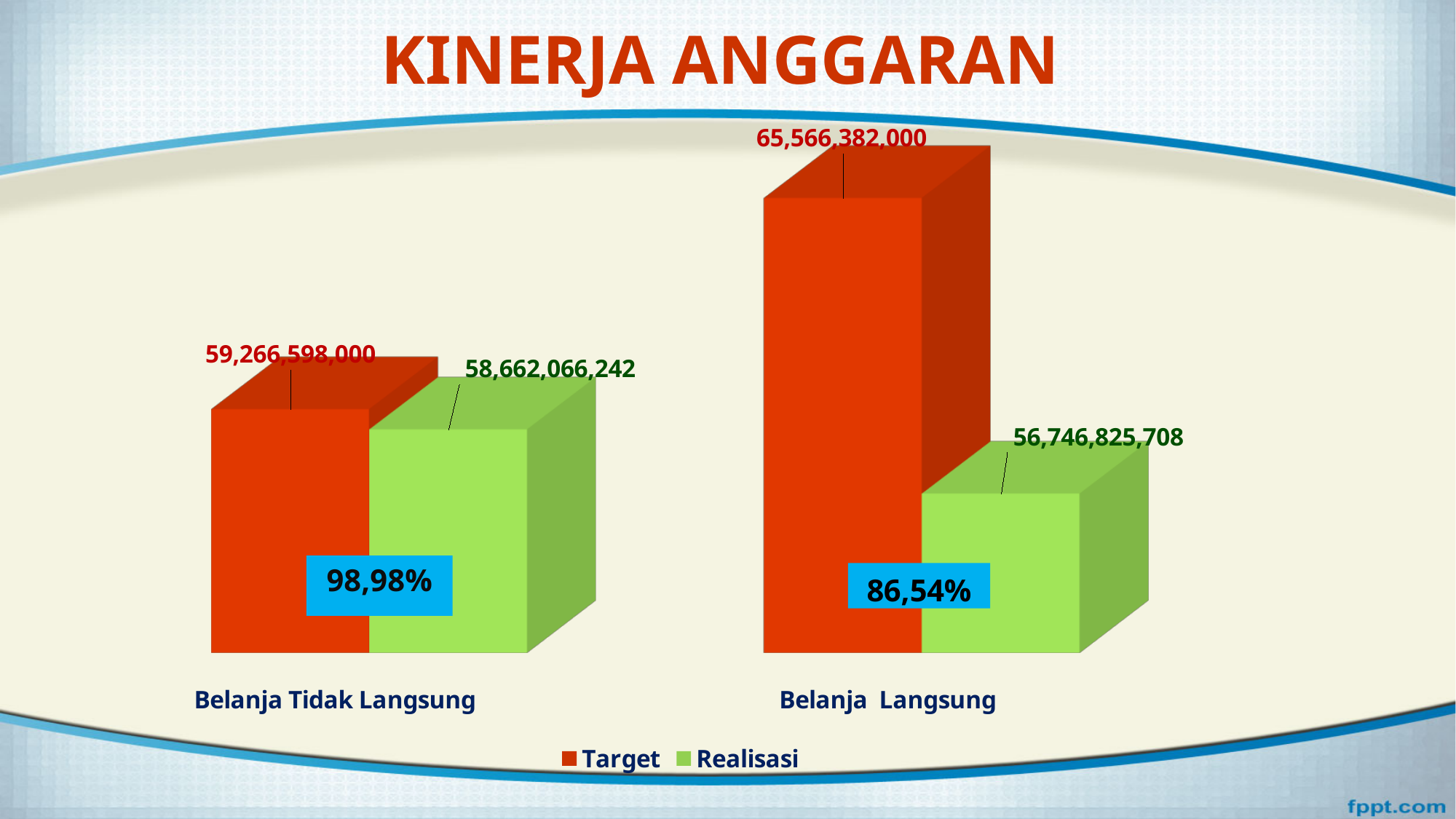
Which is larger for Belanja Tidak Langsung, the Target or the Realisasi value? Target What is the Target value for Belanja Tidak Langsung? 59,266,598,000 Which category has the highest Target value? Belanja Langsung How many series does the legend list? 2 What is the difference between the Target and Realisasi values for Belanja Langsung? 8,819,556,292 What type of chart is shown on the slide? Bar chart What percentage is shown for Belanja Langsung? 86,54% What is the Realisasi value for Belanja Langsung? 56,746,825,708 What is the Realisasi value for Belanja Tidak Langsung? 58,662,066,242 What is the difference between the Target values for Belanja Langsung and Belanja Tidak Langsung? 6,299,784,000 What is the Target value for Belanja Langsung? 65,566,382,000 Which category has the lowest Realisasi value? Belanja Langsung